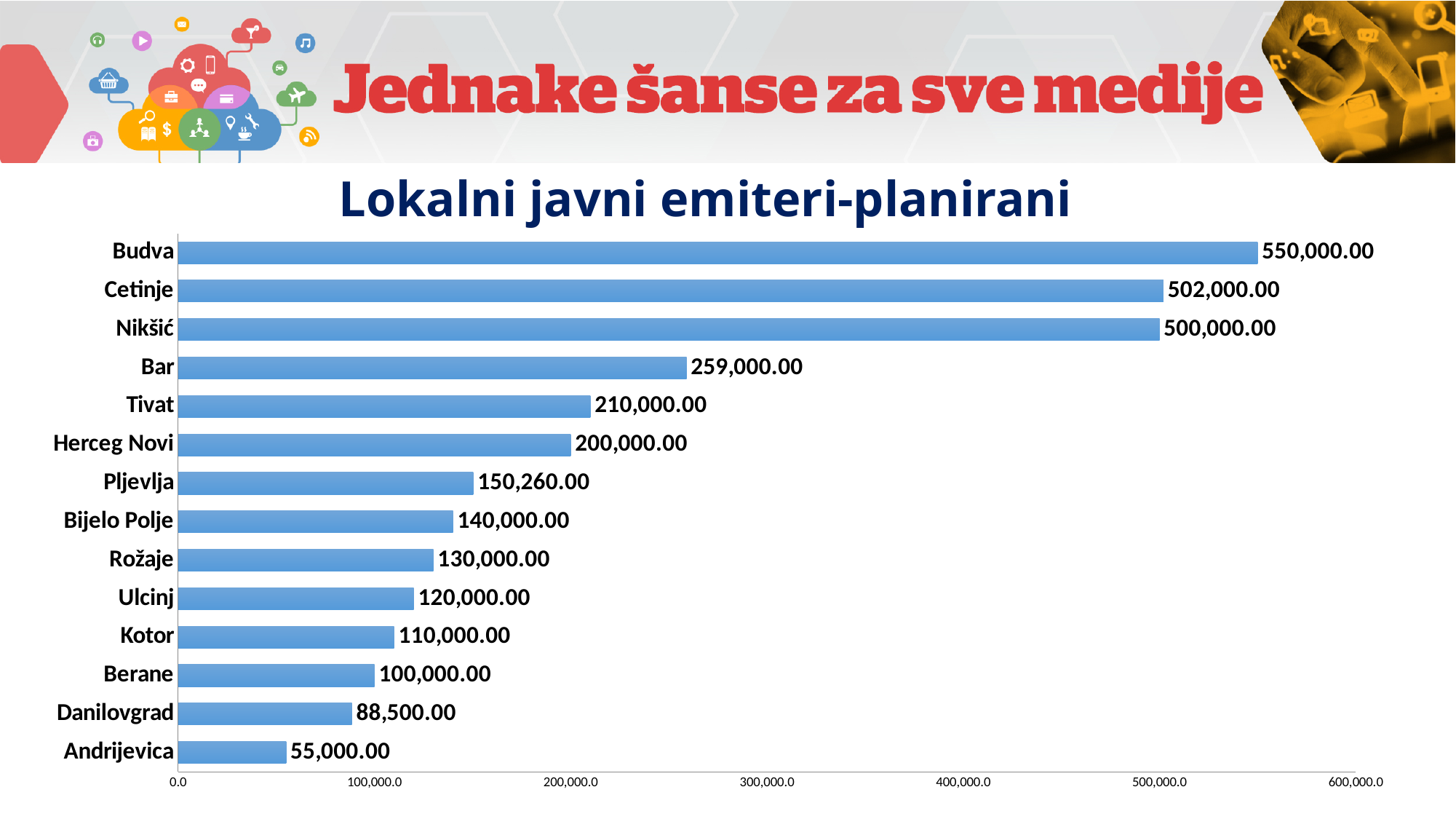
What is the difference between the values for Bar and Tivat? 49,000.00 What is the value for Budva? 550,000.00 How many categories are shown in the chart? 14 Which category has the lowest value? Andrijevica What kind of chart is shown on the slide? bar chart Is the value for Bar greater or less than 200,000.0? greater Which category has the highest value? Budva What is the difference between the values for Budva and Nikšić? 50,000.00 Which is larger, the value for Herceg Novi or the value for Bijelo Polje? Herceg Novi What is the title of the chart? Lokalni javni emiteri-planirani What is the value for Pljevlja? 150,260.00 What is the value for Danilovgrad? 88,500.00